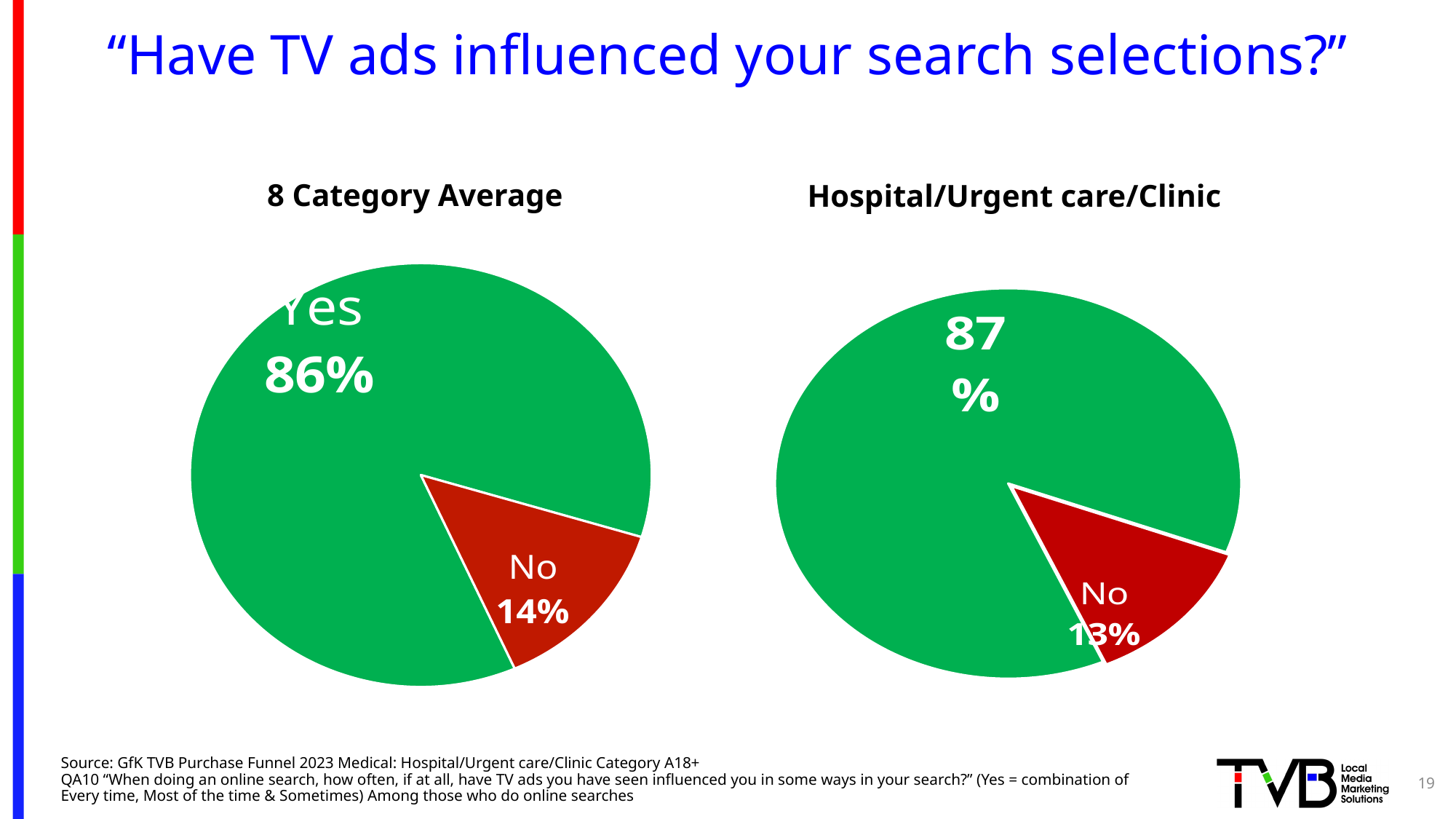
In the '8 Category Average' pie chart, what percentage answered No? 14% What is the title of the pie chart on the right side of the slide? Hospital/Urgent care/Clinic What colour is the No slice in the '8 Category Average' pie chart? Red In the '8 Category Average' pie chart, what percentage answered Yes? 86% Which chart has the larger No share, '8 Category Average' or 'Hospital/Urgent care/Clinic'? 8 Category Average In the 'Hospital/Urgent care/Clinic' pie chart, which slice is the smallest? No In the 'Hospital/Urgent care/Clinic' pie chart, what percentage answered No? 13% How many slices does the 'Hospital/Urgent care/Clinic' pie chart have? 2 In the 'Hospital/Urgent care/Clinic' pie chart, what percentage is shown for the green (Yes) slice? 87% In the '8 Category Average' pie chart, what is the difference between the Yes and No percentages? 72% In the '8 Category Average' pie chart, which slice is the largest? Yes What type of chart is used on this slide? Pie chart